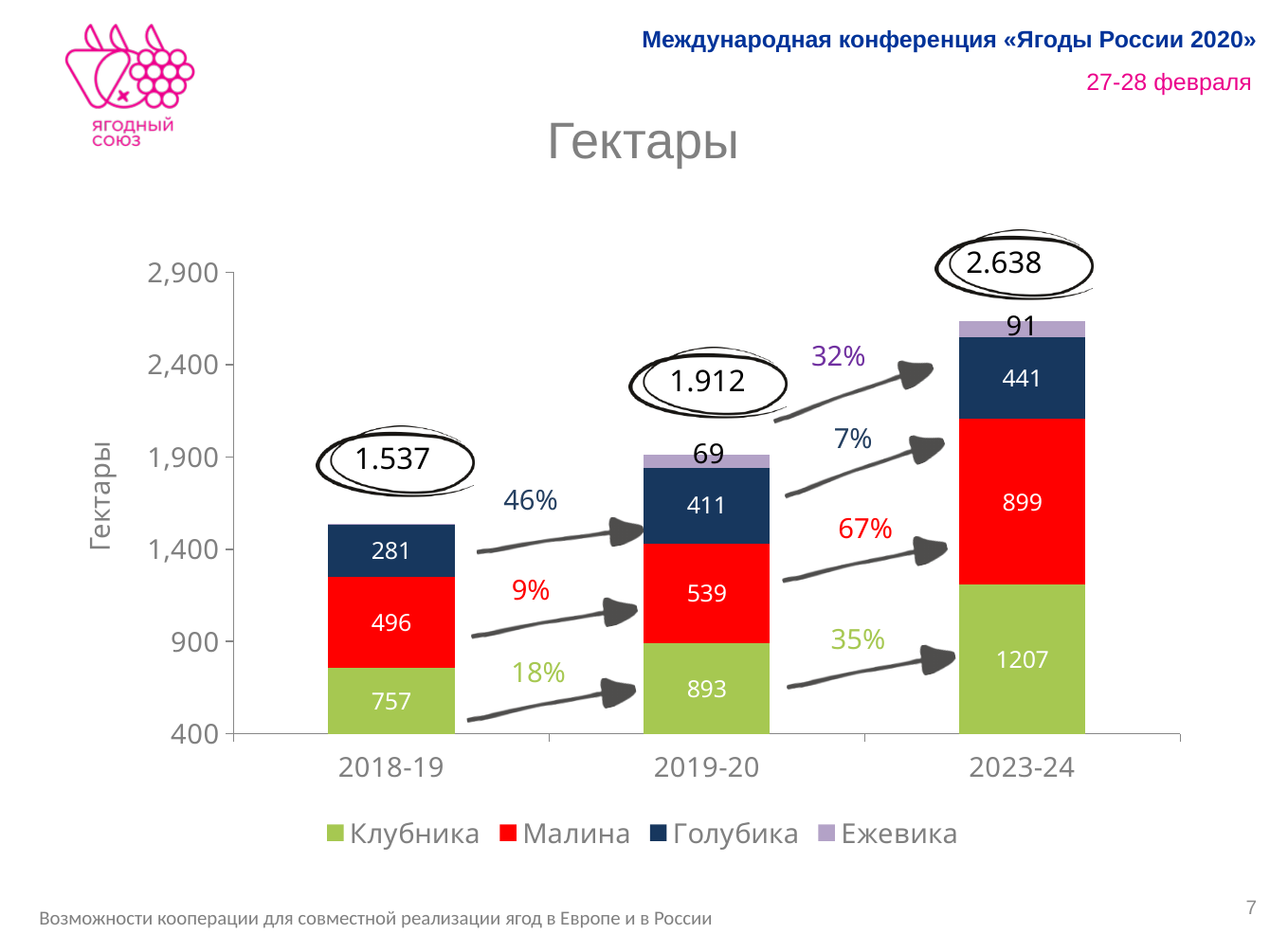
What is the value for Голубика in 2019-20? 411 How many categories are shown on the x axis? 3 Which is larger: Клубника in 2019-20 or Малина in 2023-24? Малина in 2023-24 What is the value for Малина in 2018-19? 496 How many series does the legend list? 4 Which year has the highest value for Клубника? 2023-24 Which year has the lowest value for Голубика? 2018-19 What is the value for Клубника in 2023-24? 1207 What is the total shown for the 2023-24 stacked bar? 2.638 What kind of chart is shown on the slide? Stacked bar chart What is the difference between the Малина values for 2023-24 and 2019-20? 360 What is the value for Ежевика in 2023-24? 91